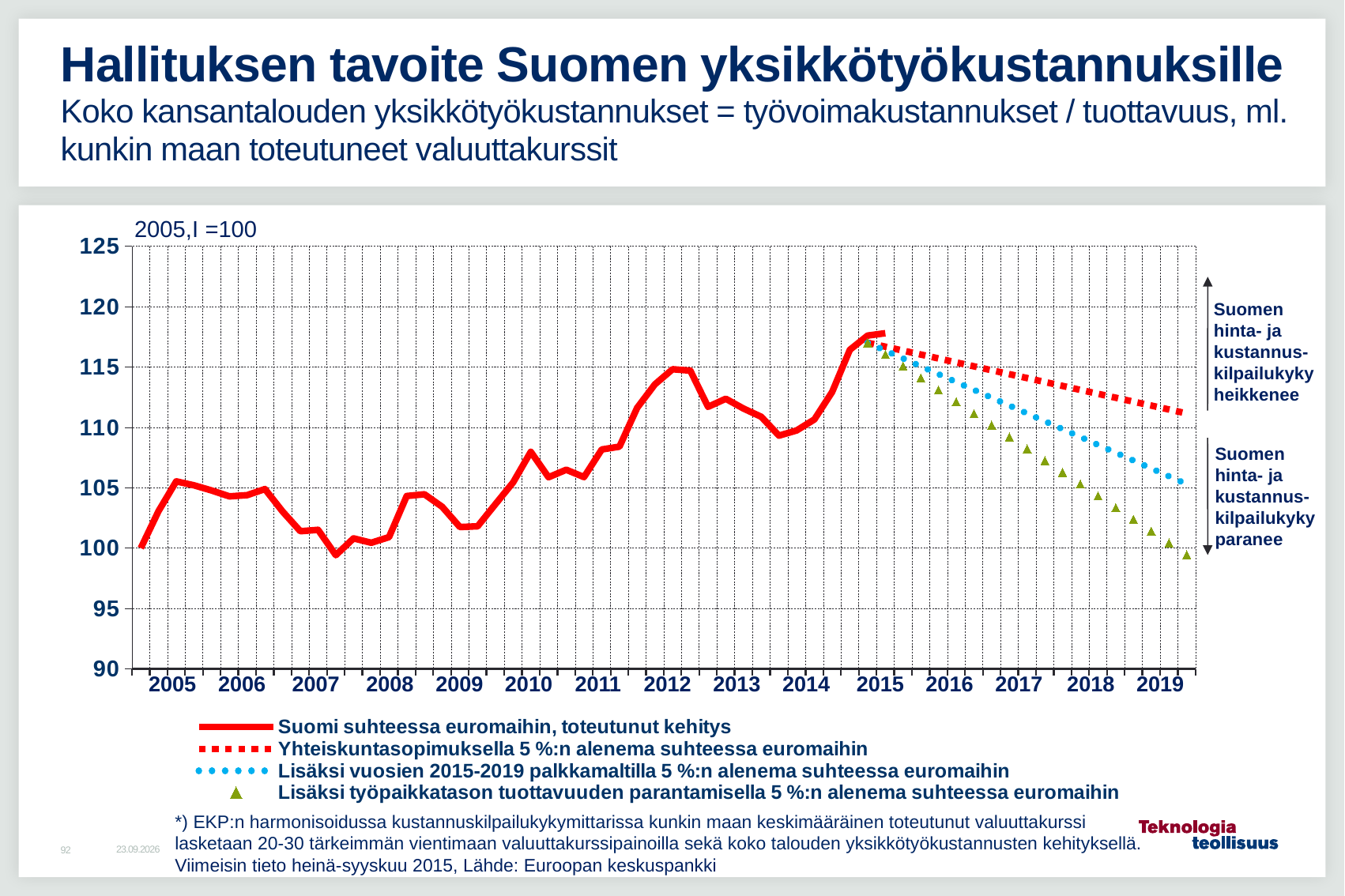
Does the solid red line rise or fall overall from 2005 to 2015? rise What kind of chart is shown on the slide? line chart What is the index base stated above the chart? 2005,I =100 How many series does the legend list? 4 What is the value of the solid red line (Suomi suhteessa euromaihin, toteutunut kehitys) at the start of 2005? 100 Is the value of the red dotted line (Yhteiskuntasopimuksella 5 %:n alenema) at the end of 2019 greater or less than 110? greater Is the value of the blue dotted line at the end of 2019 greater or less than 110? less Is the peak value of the solid red line around 2015 greater or less than 115? greater Which series ends lowest in 2019? Lisäksi työpaikkatason tuottavuuden parantamisella 5 %:n alenema suhteessa euromaihin (green triangles) At the end of 2019, which is higher: the red dotted line or the green triangle series? the red dotted line Does the red dotted line rise or fall from 2015 to 2019? fall